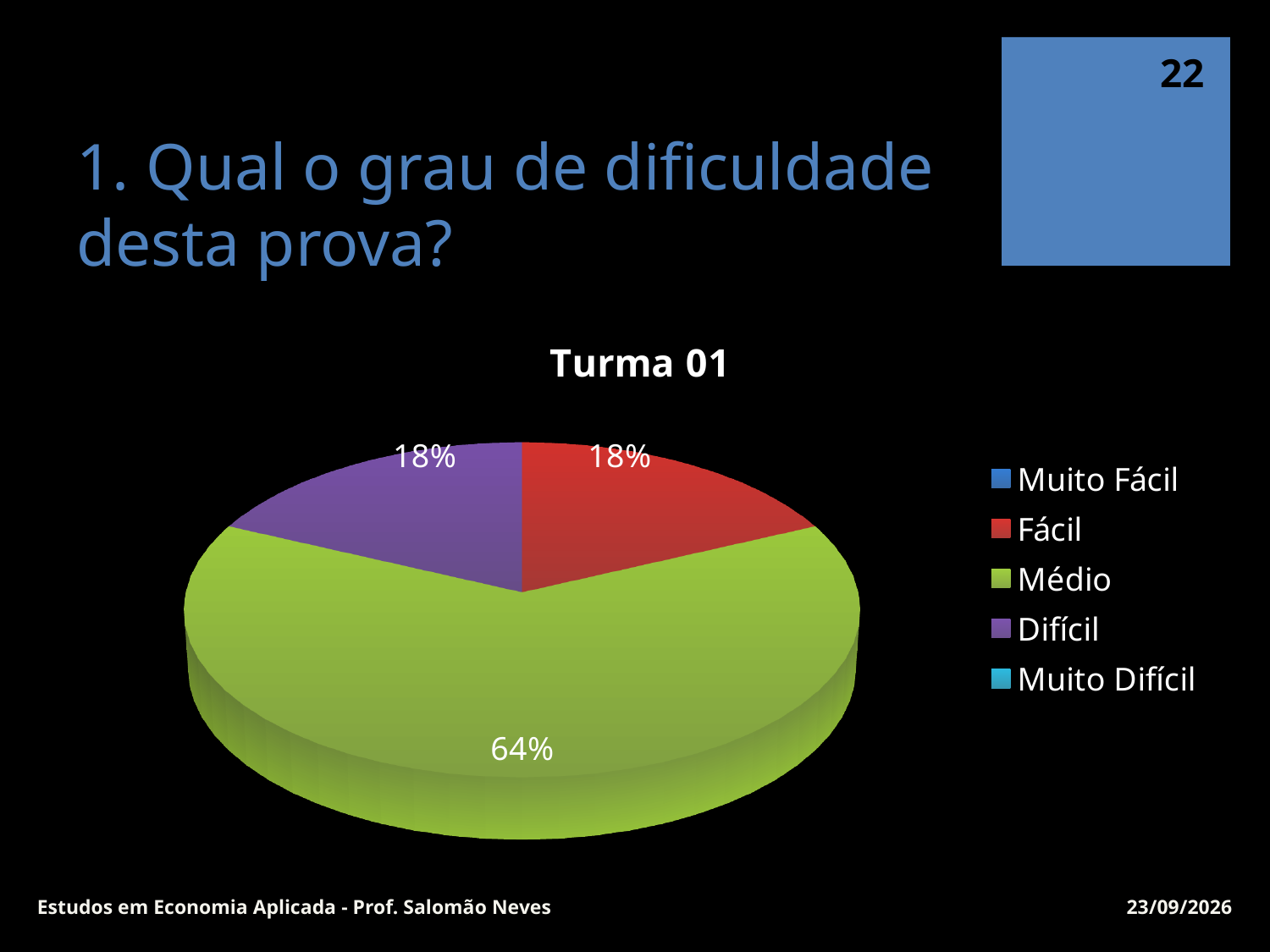
Which category has the largest slice of the pie? Médio Which is larger, the slice for Médio or the slice for Difícil? Médio What kind of chart is shown on the slide? pie chart How many entries does the legend list? 5 What is the value shown for Difícil? 18% What is the value shown for Fácil? 18% What colour is the Médio slice in the pie chart? green What share of the pie does Médio represent? 64% Is the value for Médio greater or less than 50%? greater What is the title of the pie chart? Turma 01 How many slices with data labels are visible in the pie? 3 What is the difference in percentage points between Médio and Fácil? 46